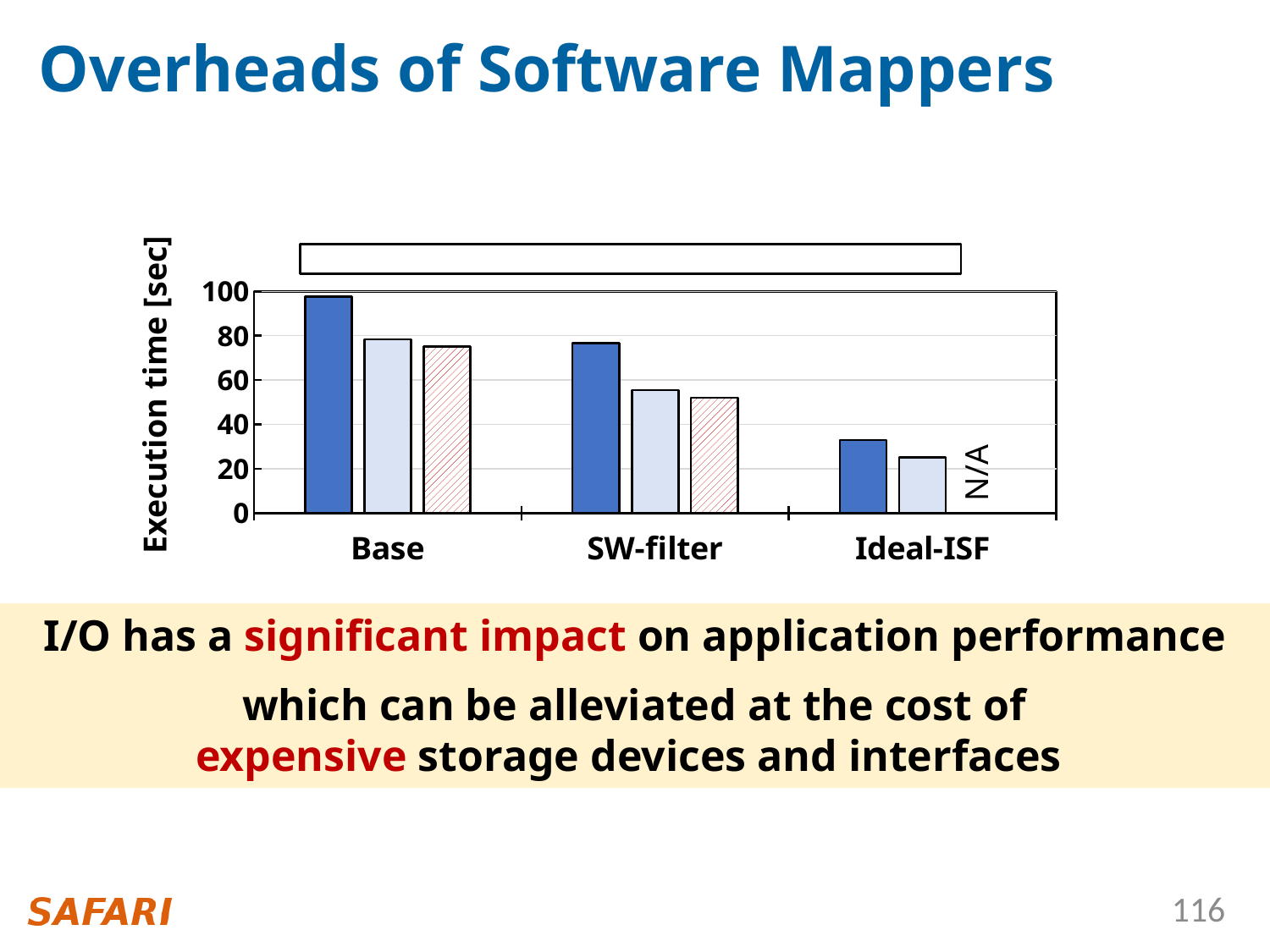
Is the dark blue bar for Ideal-ISF greater or less than 40? less What is the label of the y axis of the chart? Execution time [sec] Is the light blue bar for SW-filter greater or less than 40? greater Is the dark blue bar for SW-filter greater or less than 60? greater Which is larger, the dark blue bar for Base or the dark blue bar for SW-filter? Base How many categories are shown on the x axis of the chart? 3 What kind of chart is shown on the slide? bar chart Which category has the shortest dark blue bar? Ideal-ISF Do the dark blue bars rise or fall from Base to Ideal-ISF along the x axis? fall Which category has the tallest dark blue bar? Base Which category on the x axis shows an N/A entry instead of a third bar? Ideal-ISF